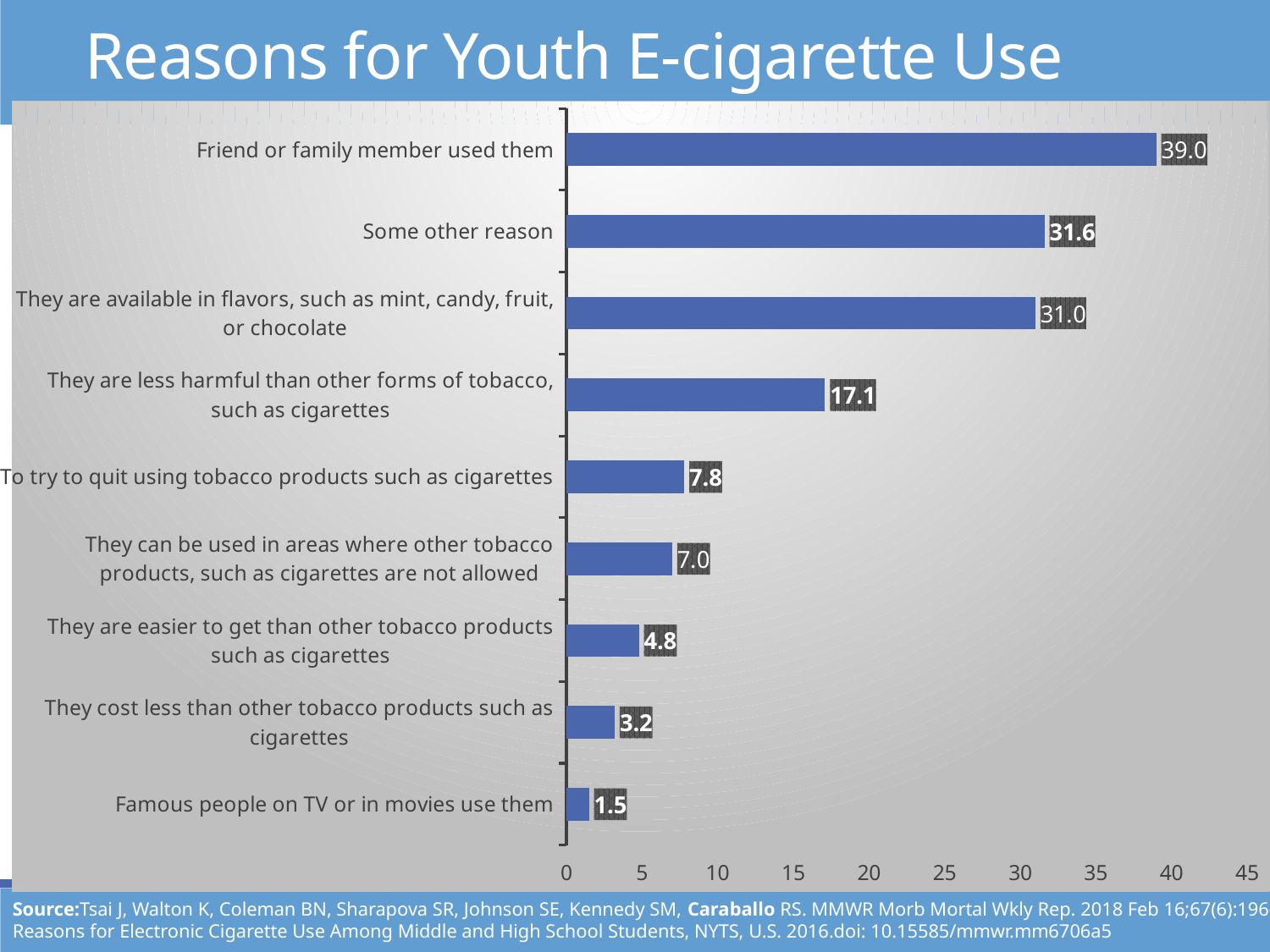
What kind of chart is shown on the slide? Bar chart What is the difference between the values for "Some other reason" and "They are available in flavors, such as mint, candy, fruit, or chocolate"? 0.6 Which is larger: the value for "To try to quit using tobacco products such as cigarettes" or the value for "They are easier to get than other tobacco products such as cigarettes"? To try to quit using tobacco products such as cigarettes What is the value for "Famous people on TV or in movies use them"? 1.5 What is the highest value shown on the horizontal axis? 45 What is the value for "They are less harmful than other forms of tobacco, such as cigarettes"? 17.1 Which reason has the lowest value? Famous people on TV or in movies use them How many reasons (categories) are shown in the chart? 9 Which reason has the highest value? Friend or family member used them Is the value for "They cost less than other tobacco products such as cigarettes" greater or less than 5? less What is the title of the slide? Reasons for Youth E-cigarette Use What is the value for "Friend or family member used them"? 39.0